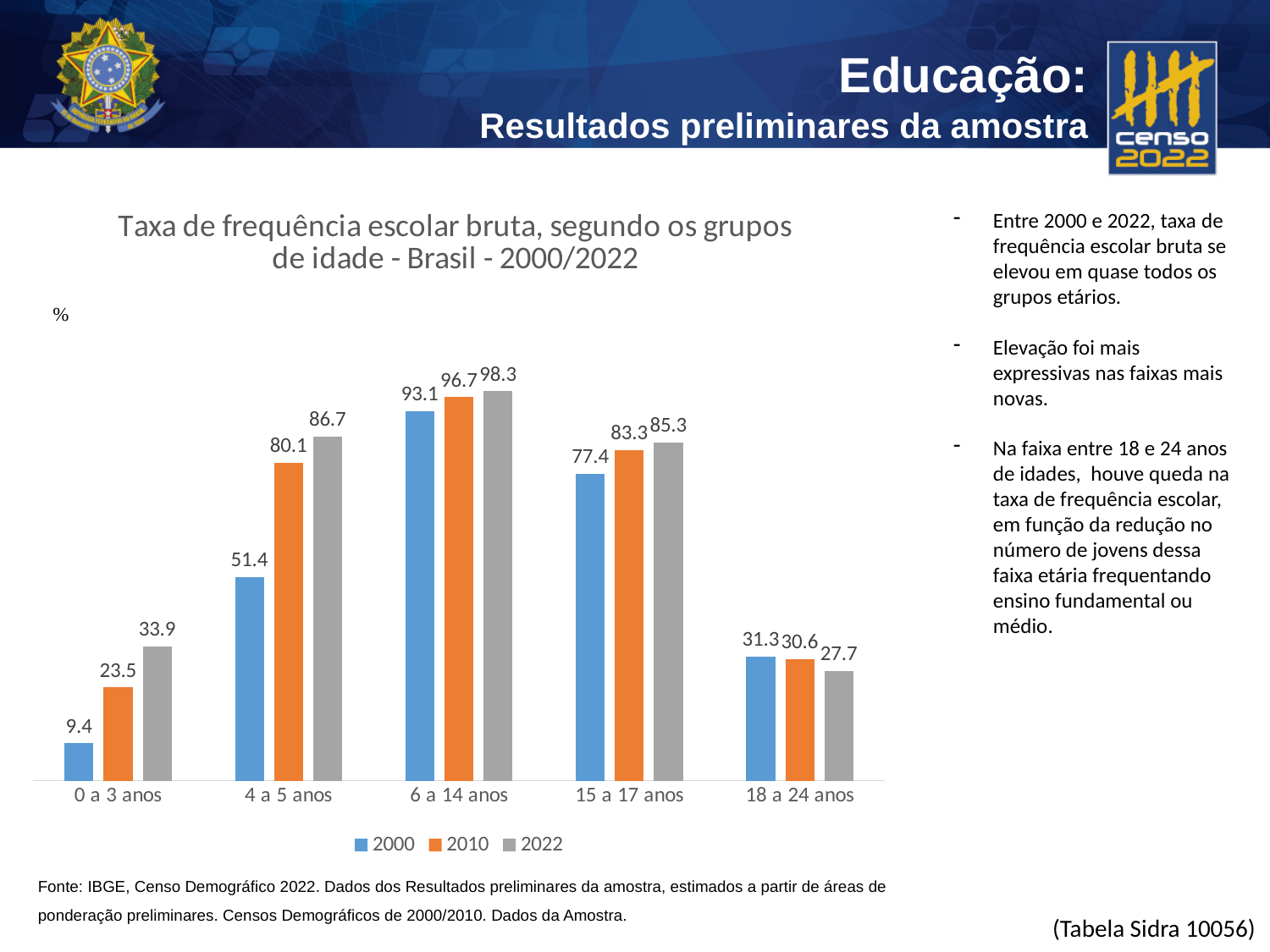
Which age group has the lowest value in the 2000 series? 0 a 3 anos Which age group has the highest value in the 2022 series? 6 a 14 anos In the '18 a 24 anos' age group, which is larger: the 2000 value or the 2022 value? 2000 What is the value for the 2000 series in the '4 a 5 anos' age group? 51.4 How many series does the legend list? 3 What is the value for the 2022 series in the '0 a 3 anos' age group? 33.9 What is the difference between the 2022 and 2000 values for the '4 a 5 anos' age group? 35.3 Which series is shown in orange in the legend? 2010 What kind of chart is shown on the slide? Bar chart How many age groups are shown on the x axis? 5 Across the three years, do the values for the '18 a 24 anos' age group rise or fall from 2000 to 2022? Fall What is the value for the 2010 series in the '15 a 17 anos' age group? 83.3